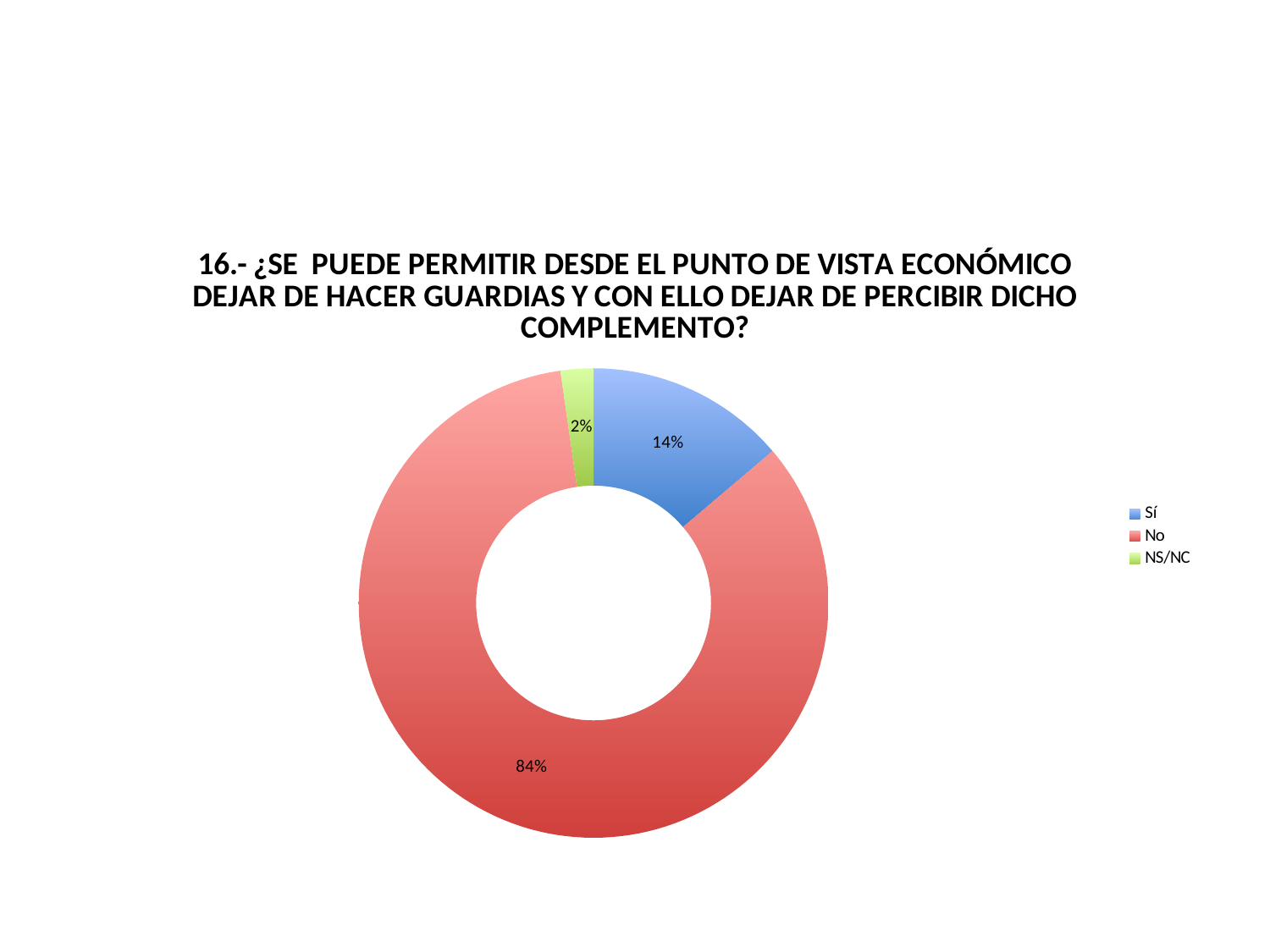
What share of the chart does the "No" slice represent? 84% Which category has the smallest slice? NS/NC What kind of chart is shown on the slide? Doughnut (pie) chart Which category has the largest slice? No Which legend entry is listed first? Sí How many categories does the chart show? 3 Which is larger, the "Sí" slice or the "NS/NC" slice? Sí What is the difference in percentage points between the "No" and "Sí" slices? 70 What colour is the "No" slice? Red What share of the chart does the "Sí" slice represent? 14% What share of the chart does the "NS/NC" slice represent? 2% What is the combined share of the "Sí" and "NS/NC" slices? 16%